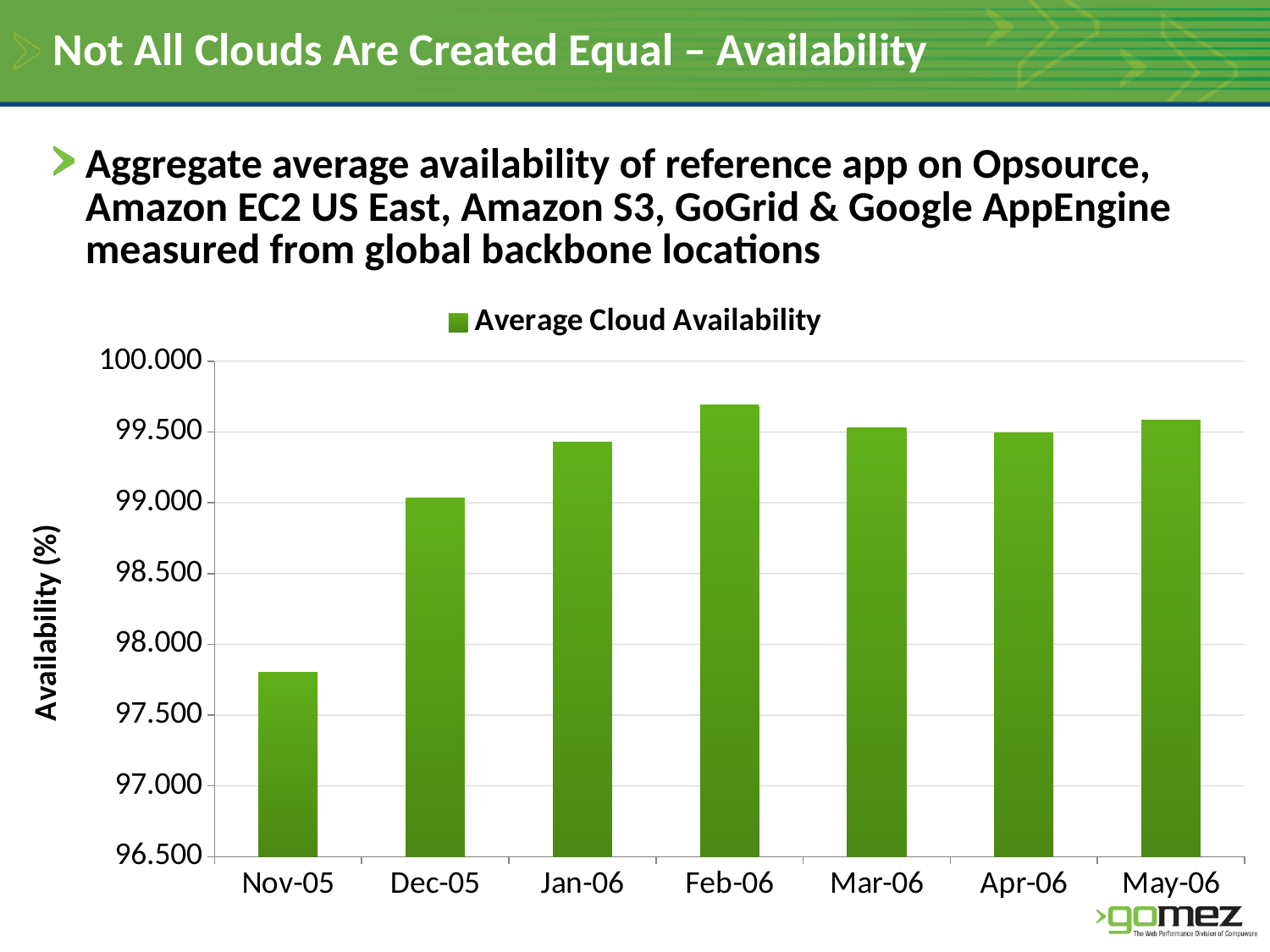
Is the value for Feb-06 greater or less than 99.500? greater Is the value for Nov-05 greater or less than 97.500? greater How many series does the chart legend list? 1 Is the value for Dec-05 greater or less than 99.500? less Which month has the lowest average cloud availability? Nov-05 What kind of chart is shown on the slide? bar chart How many months are plotted on the x axis of the chart? 7 Do the values rise or fall from Nov-05 to Feb-06? rise Which is larger, the value for Nov-05 or the value for Dec-05? Dec-05 What is the label on the vertical axis of the chart? Availability (%) Which month has the highest average cloud availability? Feb-06